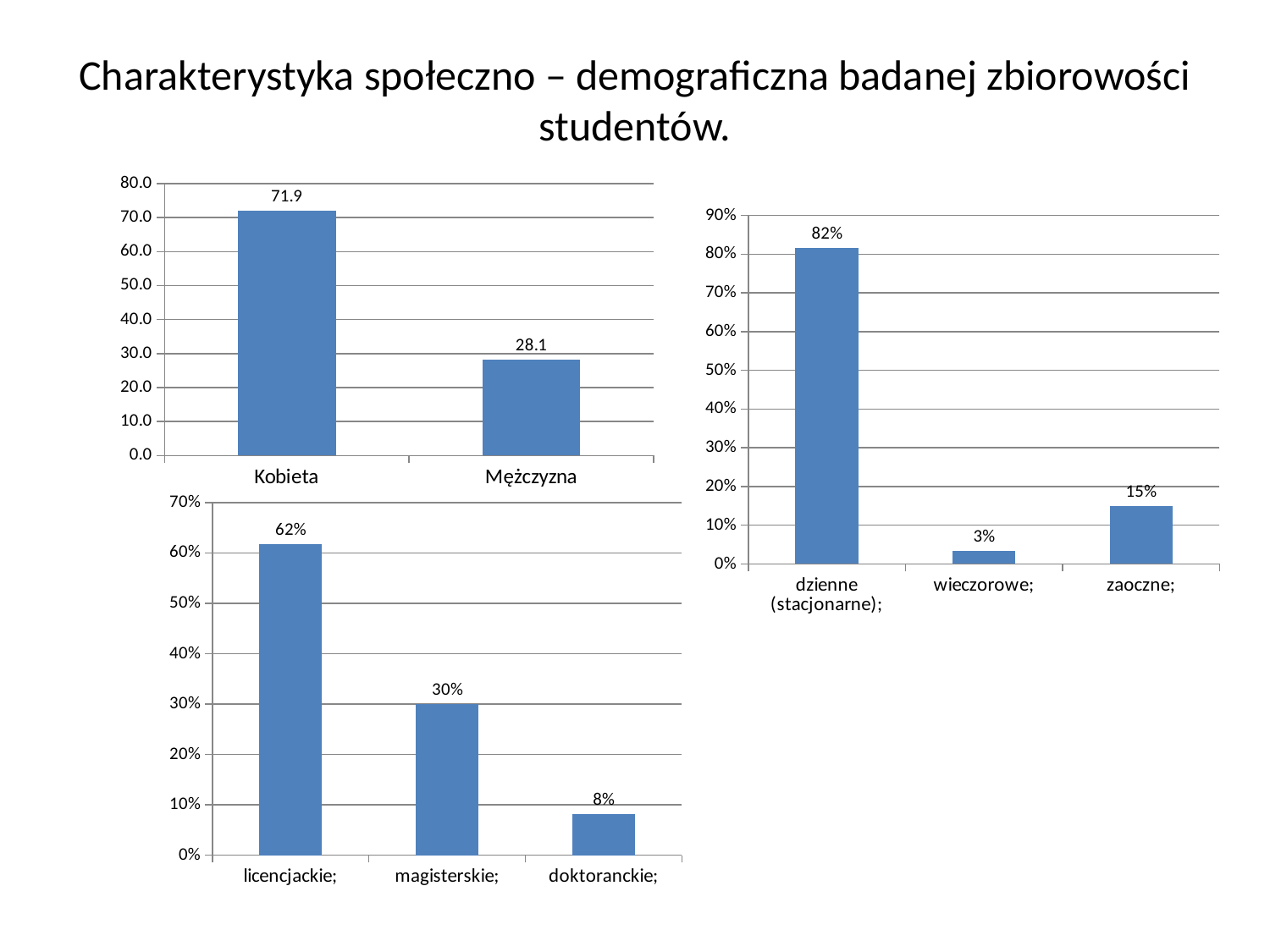
In the top-left chart (Kobieta / Mężczyzna), what is the value for Mężczyzna? 28.1 What kind of chart is the bottom-left chart (licencjackie / magisterskie / doktoranckie)? bar chart In the right chart (dzienne / wieczorowe / zaoczne), what is the difference between the values for dzienne (stacjonarne) and zaoczne? 67% In the bottom-left chart (licencjackie / magisterskie / doktoranckie), do the values rise or fall from left to right along the x axis? fall In the top-left chart (Kobieta / Mężczyzna), what is the difference between the values for Kobieta and Mężczyzna? 43.8 In the top-left chart (Kobieta / Mężczyzna), what is the value for Kobieta? 71.9 In the bottom-left chart (licencjackie / magisterskie / doktoranckie), which is larger, the value for licencjackie or the value for doktoranckie? licencjackie In the bottom-left chart (licencjackie / magisterskie / doktoranckie), what is the value for magisterskie? 30% In the right chart (dzienne / wieczorowe / zaoczne), which category has the highest value? dzienne (stacjonarne) In the right chart (dzienne / wieczorowe / zaoczne), which category has the lowest value? wieczorowe In the top-left chart (Kobieta / Mężczyzna), how many categories are shown? 2 In the right chart (dzienne / wieczorowe / zaoczne), what is the value for zaoczne? 15%